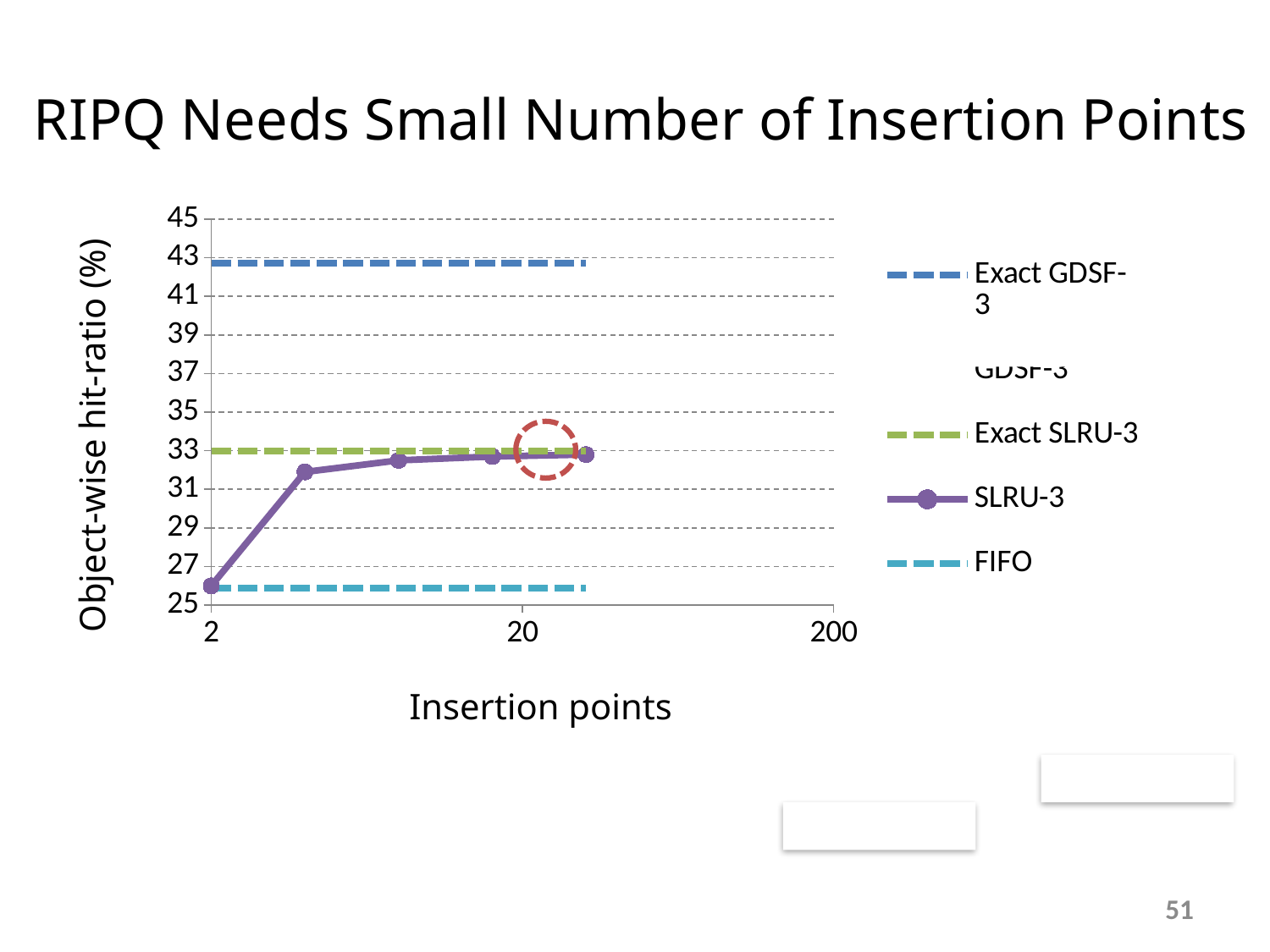
What is the title of the x axis? Insertion points How many data points are plotted on the SLRU-3 line? 5 What is the title of the y axis? Object-wise hit-ratio (%) Which is higher, Exact GDSF-3 or Exact SLRU-3? Exact GDSF-3 Does the SLRU-3 hit-ratio rise or fall as the number of insertion points increases? rise What kind of chart is shown on the slide? line chart Is the value for SLRU-3 at 2 insertion points greater or less than 27? less Which series has the lowest hit-ratio on the chart? FIFO Is the value for Exact GDSF-3 greater or less than 41? greater Is the value for FIFO greater or less than 27? less Which series has the highest hit-ratio on the chart? Exact GDSF-3